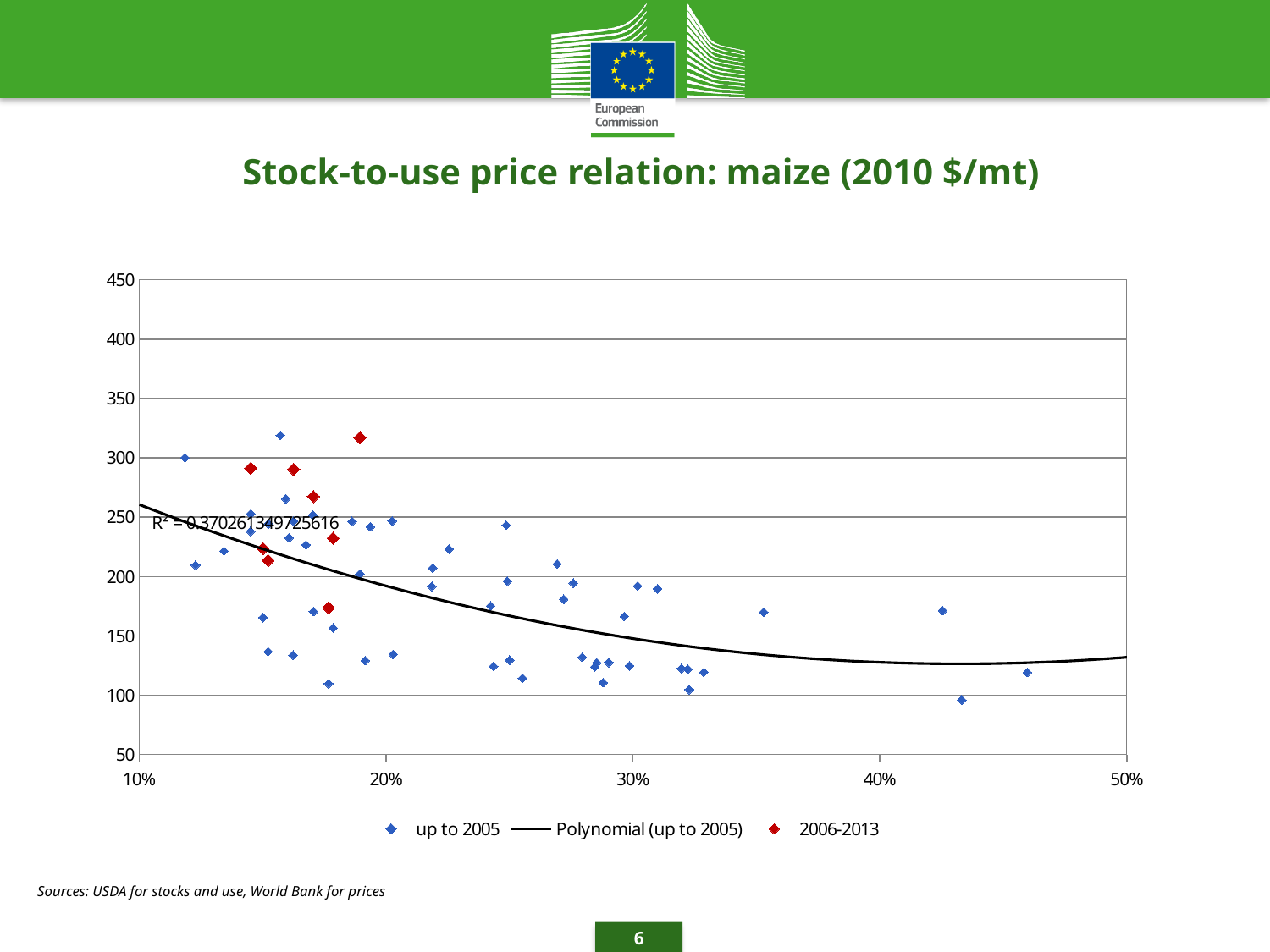
Which series is plotted with red diamond markers? 2006-2013 What kind of chart is shown on the slide? Scatter chart Is the 'up to 2005' point at about 46% stock-to-use greater or less than 150? less How many entries does the chart legend list? 3 Is the lowest 'up to 2005' (blue) point, near 43% stock-to-use, greater or less than 100? less What R² value is printed on the chart? R² = 0.370261349725616 Is the highest 2006-2013 (red) point greater or less than 300? greater How many 2006-2013 (red) data points are plotted on the chart? 8 What is the title of the chart? Stock-to-use price relation: maize (2010 $/mt) Does the polynomial trend line rise or fall as the stock-to-use ratio increases from 10% to 30%? Fall What is the maximum value shown on the vertical axis? 450